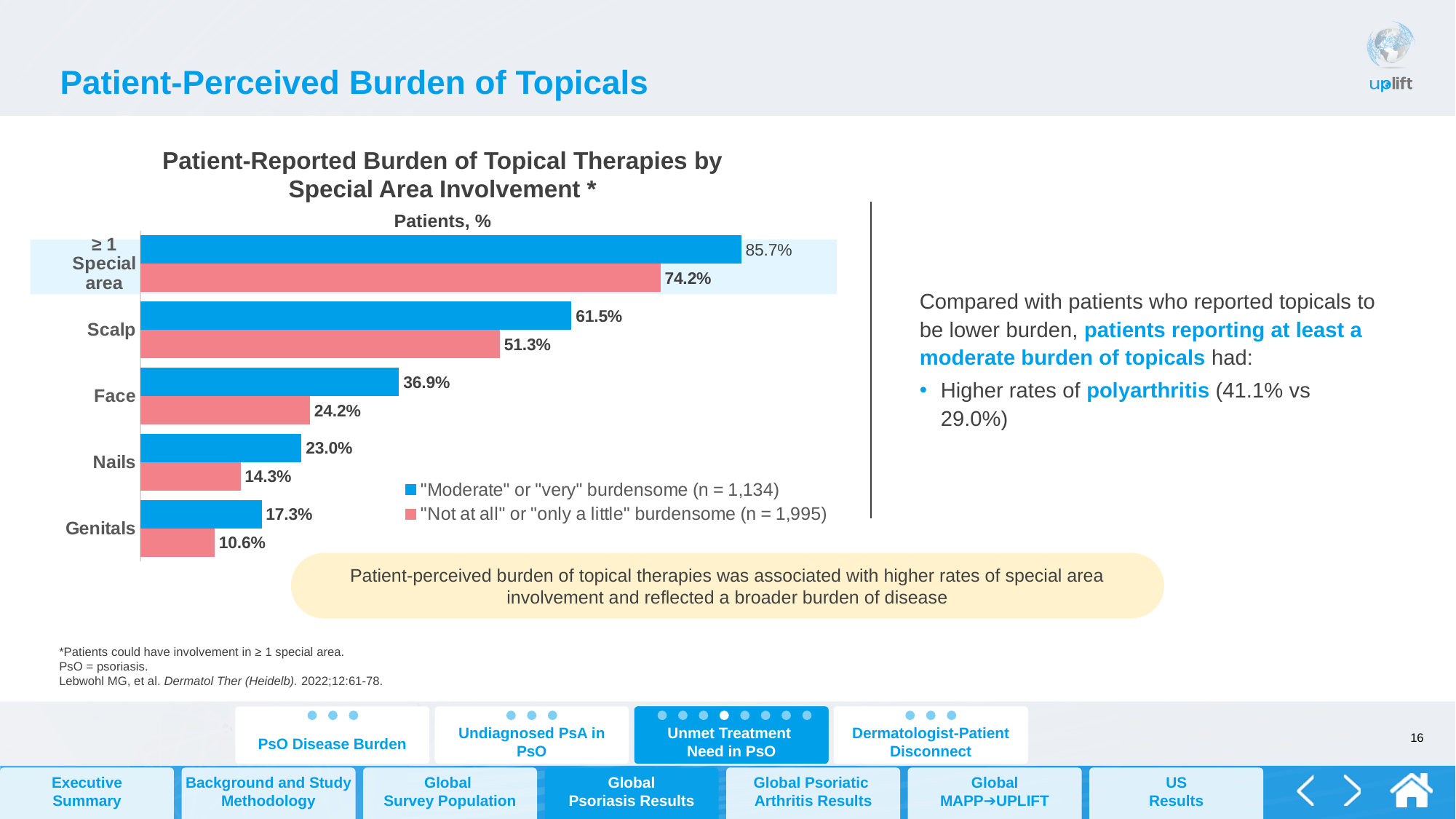
What percentage of patients reporting "moderate" or "very" burdensome topicals had scalp involvement? 61.5% What is the difference between the "Moderate" or "very" and "Not at all" or "only a little" values for ≥ 1 Special area? 11.5% Which special area has the lowest value in the "Not at all" or "only a little" burdensome series? Genitals What is the sample size (n) for the "Not at all" or "only a little" burdensome group in the legend? 1,995 What percentage of patients reporting "not at all" or "only a little" burdensome topicals had face involvement? 24.2% How many series does the legend list? 2 What is the difference between the two series for Nails? 8.7% Which special area has the highest value in the "Moderate" or "very" burdensome series? ≥ 1 Special area Which is larger for Face: the "Moderate" or "very" burdensome value or the "Not at all" or "only a little" burdensome value? "Moderate" or "very" burdensome How many special area categories are shown on the chart? 5 What is the value for Genitals in the "Not at all" or "only a little" burdensome series? 10.6% What kind of chart is shown on the slide? Bar chart